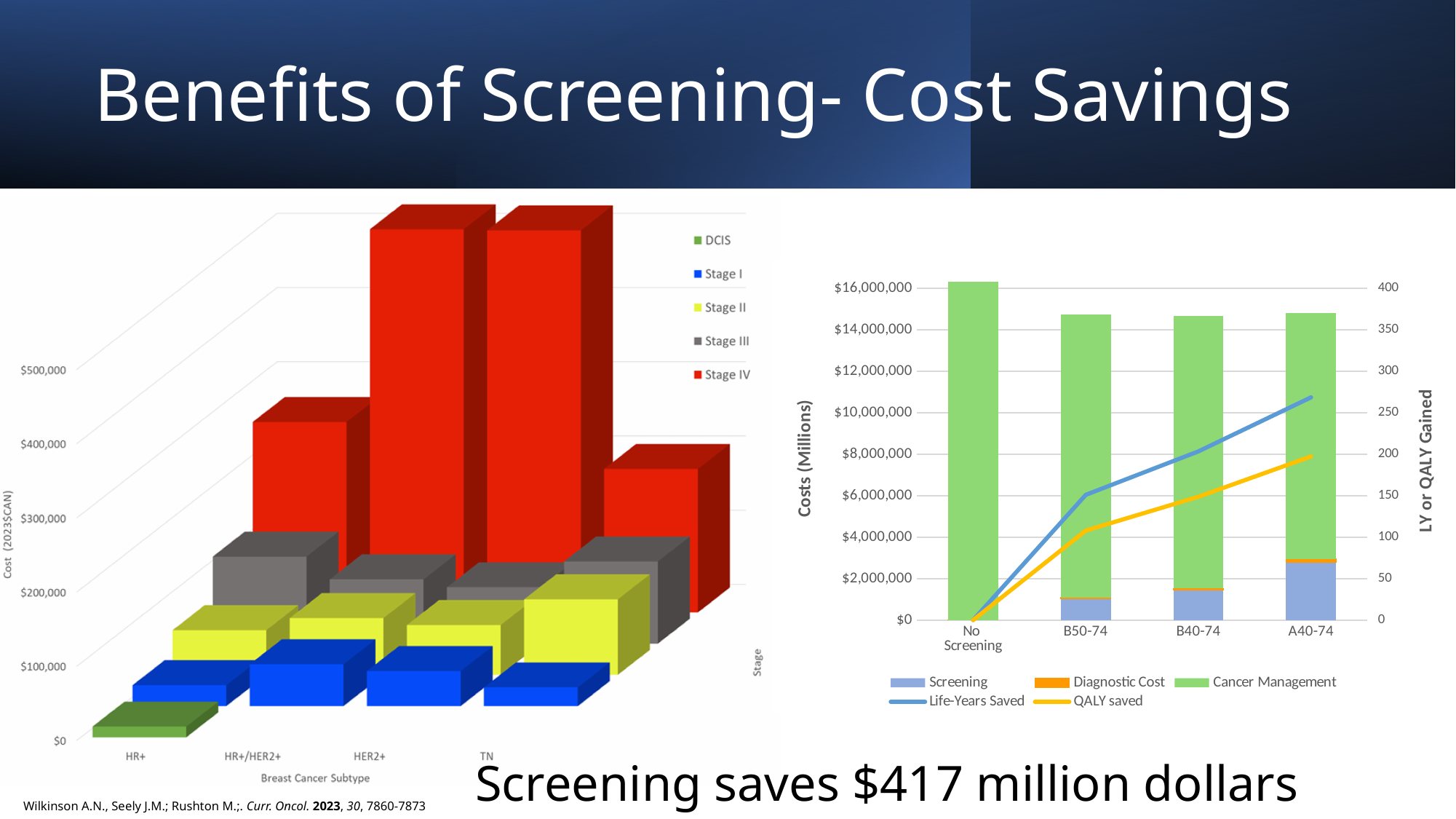
On the left chart, what is the y-axis label? Cost (2023$CAN) On the left chart, which stage has the highest cost for every subtype? Stage IV On the left chart, is the Stage IV cost for TN greater or less than the Stage IV cost for HER2+? less On the left chart, how many stages does the legend list? 5 On the right chart, is the Cancer Management cost for No Screening greater or less than $14,000,000? greater On the right chart, do the Life-Years Saved rise or fall from No Screening to A40-74? rise On the right chart, which scenario has the highest Cancer Management cost? No Screening On the right chart, how many screening scenarios are shown on the x axis? 4 On the right chart, how many series does the legend list? 5 On the left chart, which stage is shown in red? Stage IV On the right chart, which scenario has the highest Screening cost? A40-74 On the left chart, how many breast cancer subtypes are shown on the x axis? 4